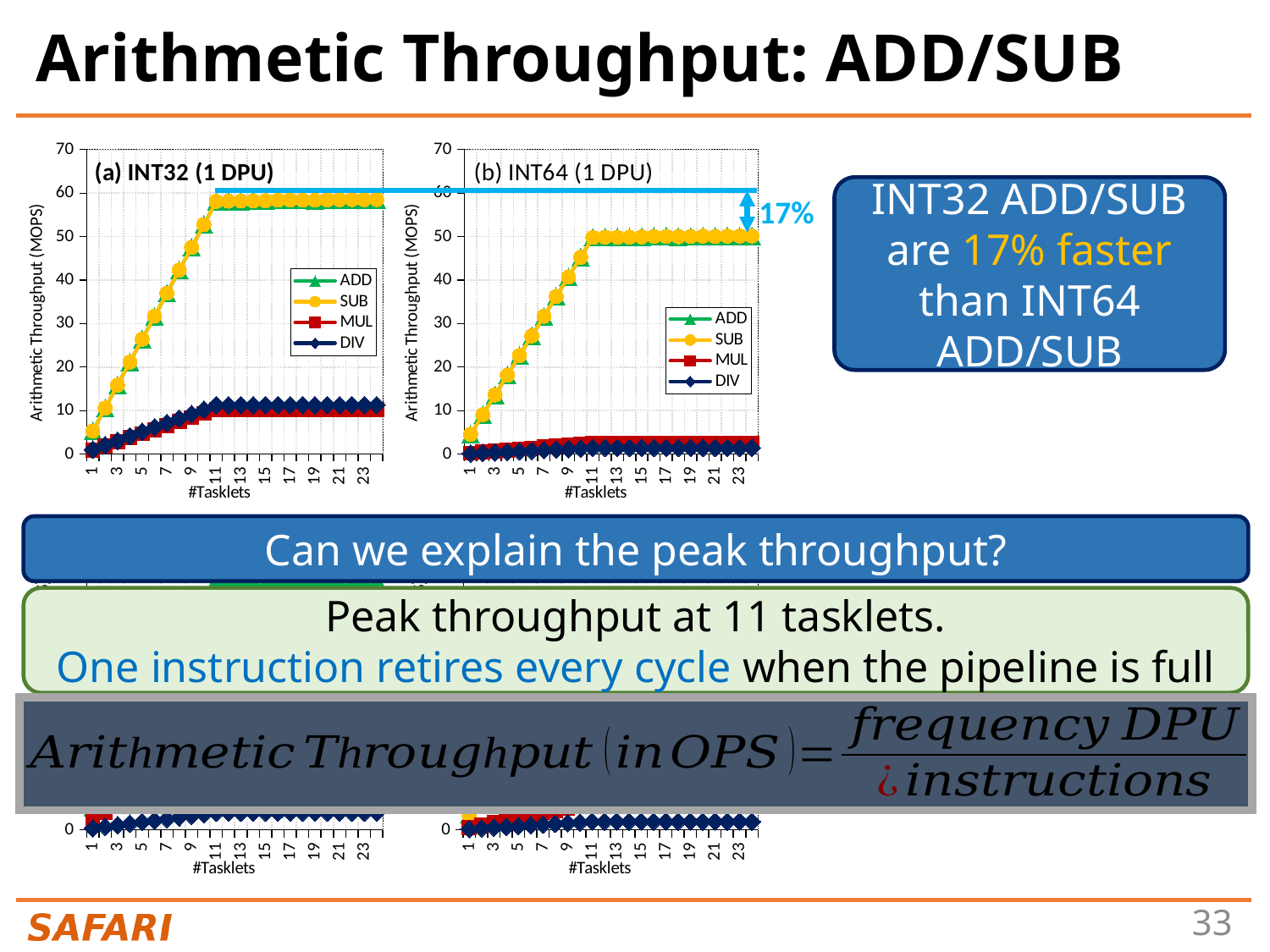
In the (b) INT64 (1 DPU) chart, is the SUB value at 23 tasklets greater or less than 60? less In the (a) INT32 (1 DPU) chart, is the ADD value at 23 tasklets greater or less than 50? greater How many series does the legend of the (b) INT64 (1 DPU) chart list? 4 In the (b) INT64 (1 DPU) chart, is the ADD value at 5 tasklets greater or less than 30? less What is the y-axis label of the (b) INT64 (1 DPU) chart? Arithmetic Throughput (MOPS) What kind of chart is the (a) INT32 (1 DPU) chart? line chart In the (a) INT32 (1 DPU) chart, does the ADD series rise or fall from 1 to 11 tasklets? rise Is the peak ADD throughput higher in the (a) INT32 (1 DPU) chart or the (b) INT64 (1 DPU) chart? (a) INT32 (1 DPU) What are the legend entries in the (a) INT32 (1 DPU) chart? ADD, SUB, MUL, DIV In the (a) INT32 (1 DPU) chart, which is higher at 23 tasklets, ADD or MUL? ADD